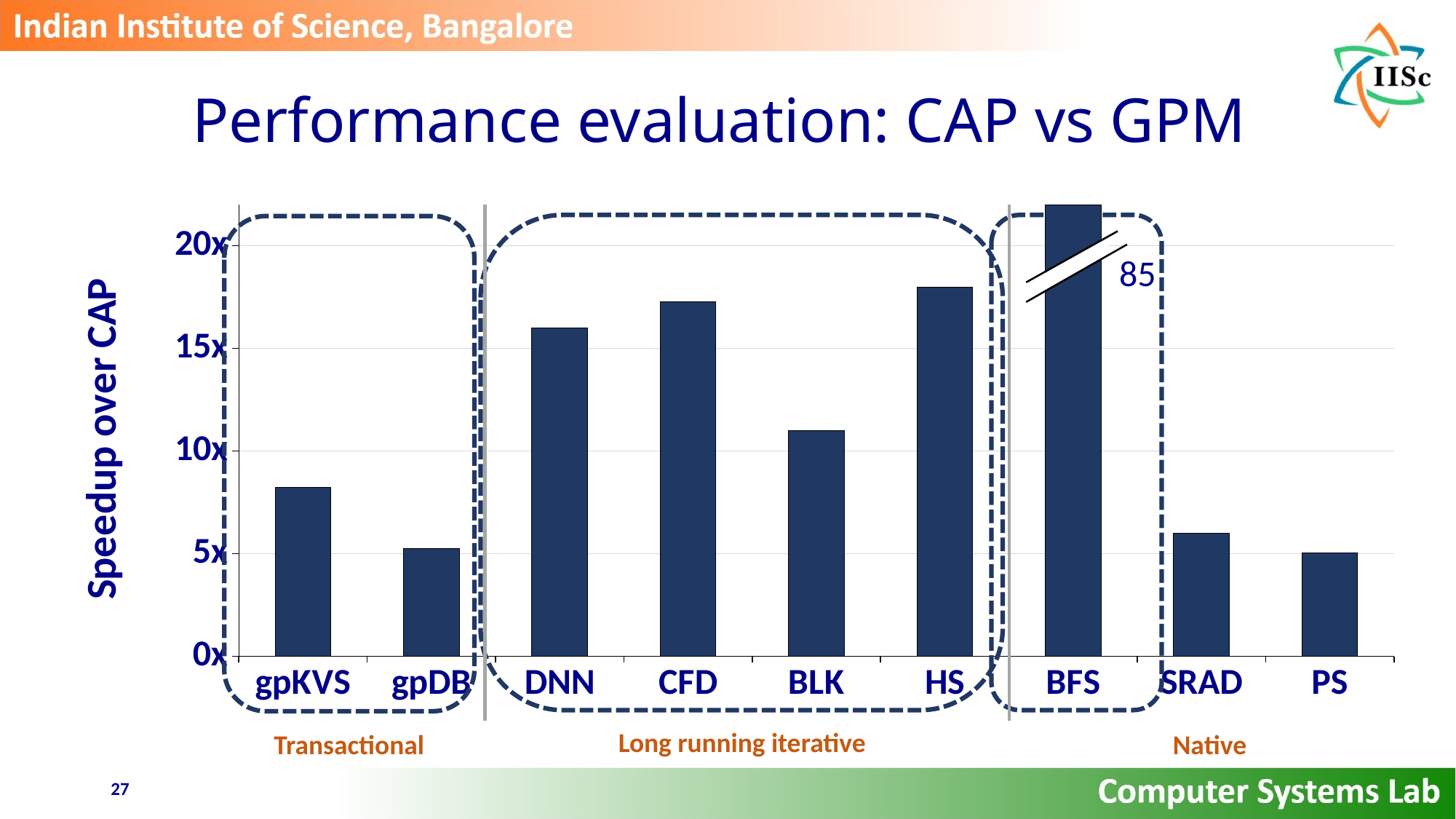
Is the speedup for DNN greater or less than 15x? greater Which has the larger speedup over CAP, gpKVS or gpDB? gpKVS What is the label of the y axis? Speedup over CAP Is the speedup for CFD greater or less than 20x? less Is the speedup for gpKVS greater or less than 5x? greater Which benchmark has the highest speedup over CAP? BFS Which has the larger speedup over CAP, DNN or BLK? DNN What kind of chart is shown on the slide? bar chart What speedup value is annotated for the BFS bar? 85 How many categories (benchmarks) are plotted on the x axis? 9